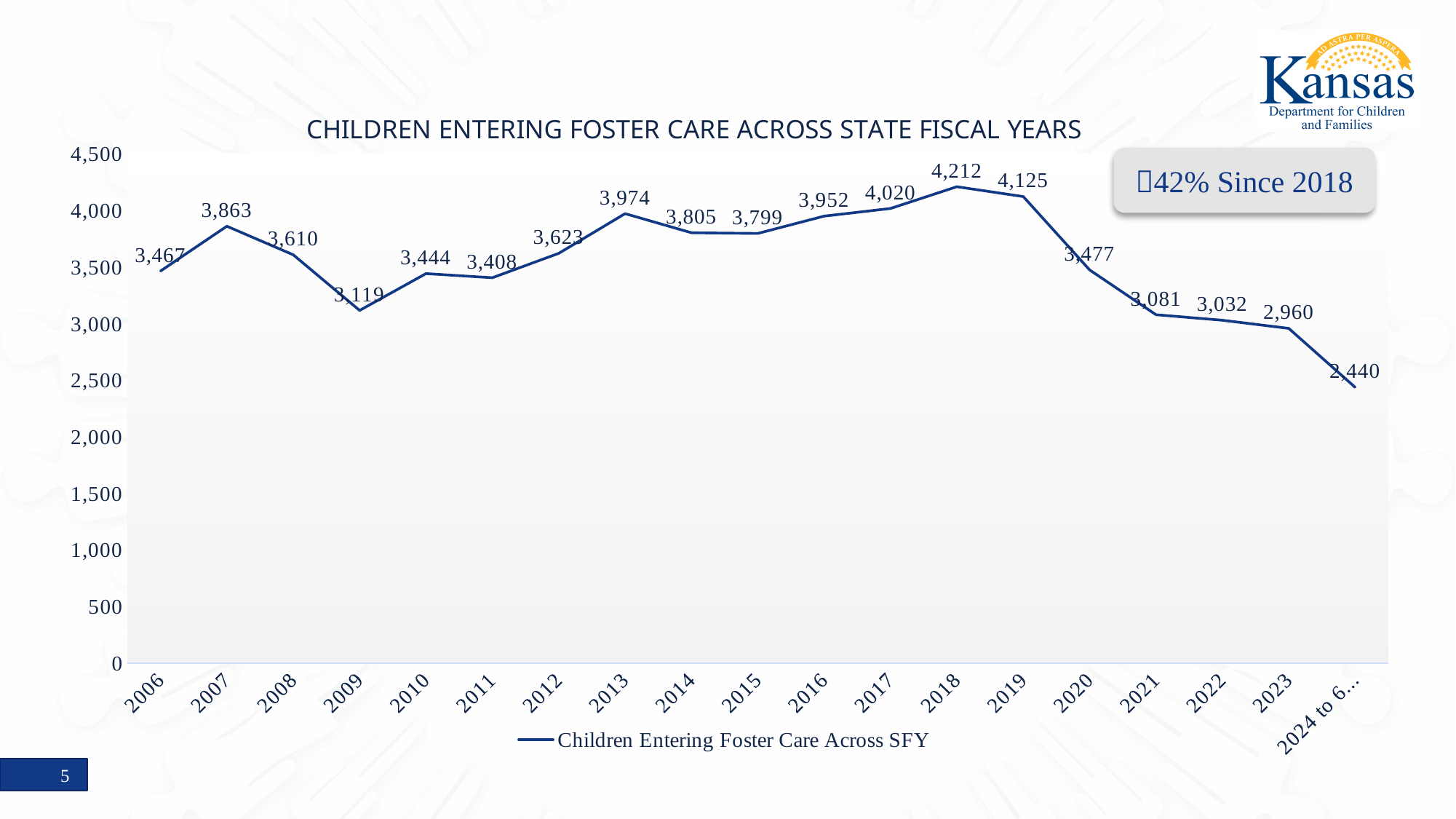
What kind of chart is shown on the slide? Line chart What is the difference between the values for 2007 and 2006? 396 What is the value for 2023? 2,960 What is the value for 2018? 4,212 What is the difference between the values for 2018 and 2019? 87 Among the years 2006 through 2023, which year has the lowest value? 2023 Which year has the highest number of children entering foster care? 2018 Do the values rise or fall from 2018 to 2023? Fall How many data points are plotted on the chart? 19 Is the value for 2020 greater or less than 3,000? greater What is the value for 2009? 3,119 Which is larger, the value for 2013 or the value for 2016? 2013